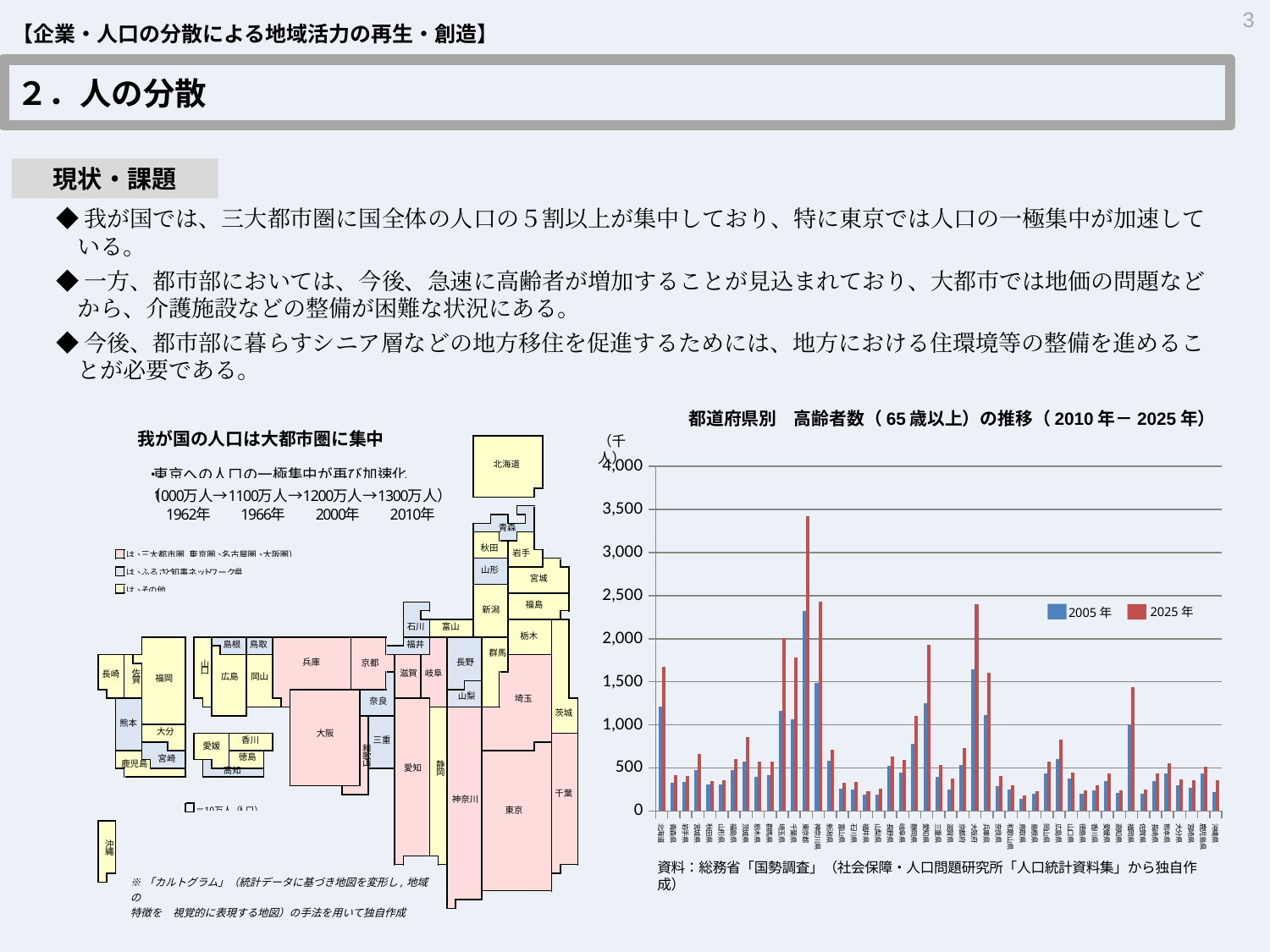
In the bar chart on the right, is the tallest bar greater or less than 3,000? greater In the bar chart on the right, is the tallest 2005年 bar greater or less than 2,000? greater In the bar chart on the right, which series does the tallest bar belong to? 2025年 What kind of chart is shown on the right side of the slide? bar chart In the bar chart on the right, for the prefecture with the tallest bar, is the 2025年 value larger or smaller than the 2005年 value? larger What is the title of the bar chart on the right? 都道府県別 高齢者数（65歳以上）の推移（2010年－2025年） What are the two series named in the legend of the bar chart on the right? 2005年 and 2025年 In the bar chart on the right, is the tallest bar greater or less than 4,000? less How many series does the legend of the bar chart on the right list? 2